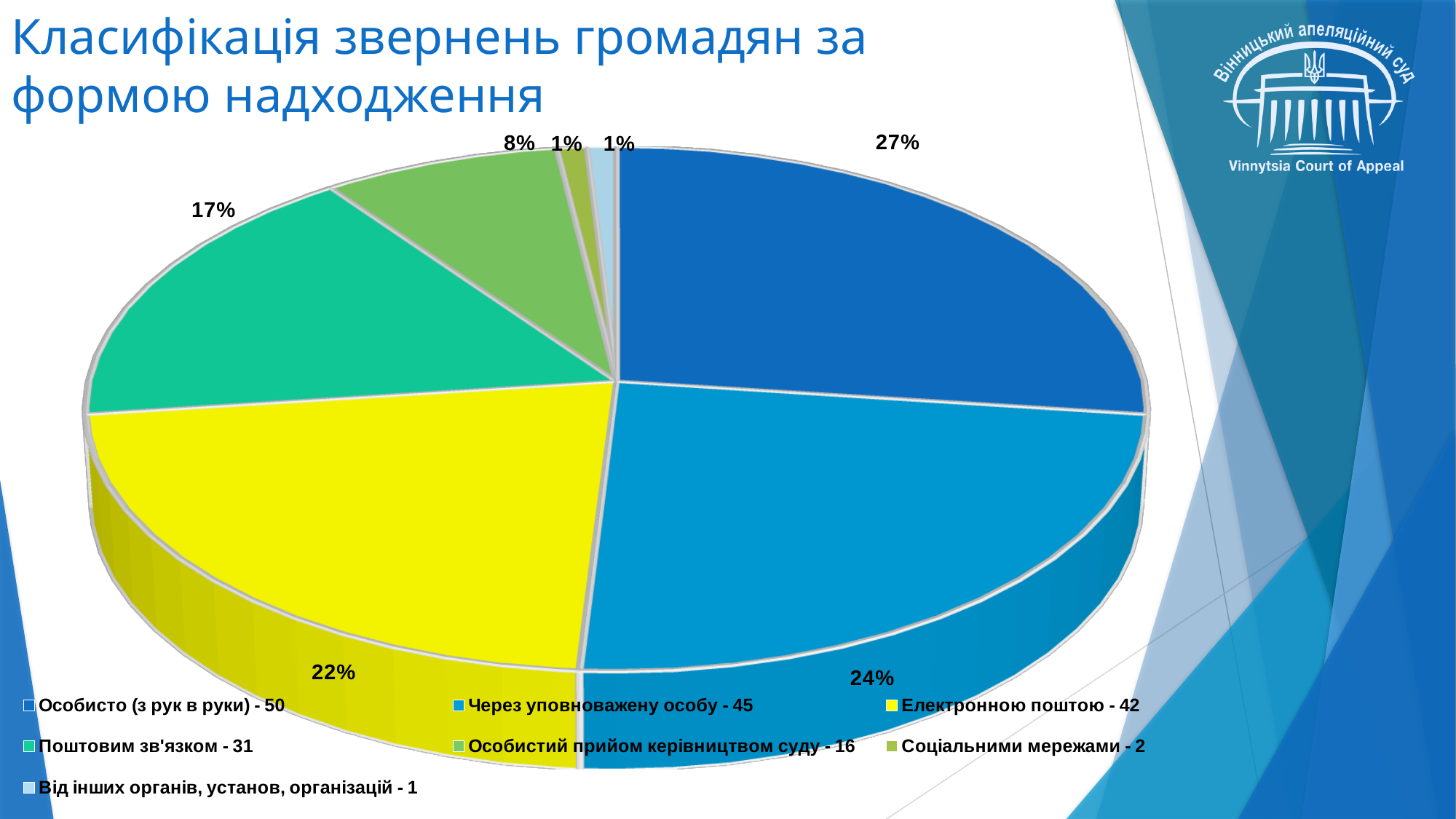
What share of the pie does "Особистий прийом керівництвом суду" take? 8% What share of the pie does "Особисто (з рук в руки)" take? 27% What is the total of all counts listed in the legend? 187 What kind of chart is shown on the slide? pie chart Which is larger: the count for "Електронною поштою" or for "Поштовим зв'язком"? Електронною поштою What count is shown in the legend for "Поштовим зв'язком"? 31 What is the difference between the counts for "Особисто (з рук в руки)" and "Через уповноважену особу"? 5 What share of the pie does "Електронною поштою" take? 22% What is the title of the chart on the slide? Класифікація звернень громадян за формою надходження How many categories does the pie chart have? 7 Which category has the smallest count according to the legend? Від інших органів, установ, організацій Which category has the largest slice of the pie? Особисто (з рук в руки)